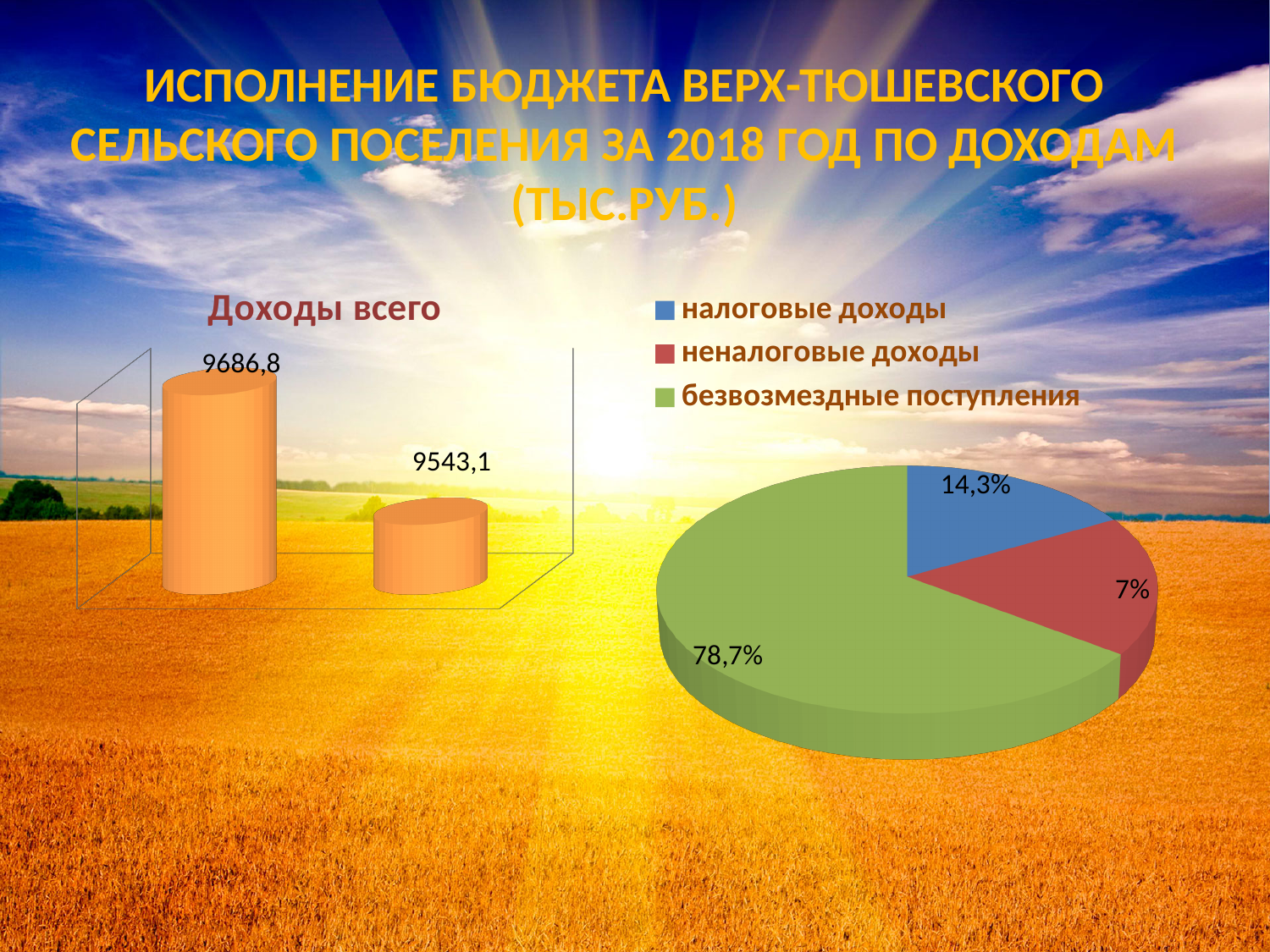
In the bar chart titled "Доходы всего", what value is printed on the left bar? 9686,8 In the pie chart on the right, which category has the largest share? безвозмездные поступления In the bar chart titled "Доходы всего", what is the difference between the left bar value and the right bar value? 143,7 In the pie chart on the right, what share is shown for "неналоговые доходы"? 7% In the bar chart titled "Доходы всего", what value is printed on the right bar? 9543,1 In the pie chart on the right, what share is shown for "безвозмездные поступления"? 78,7% In the pie chart on the right, which category has the smallest share? неналоговые доходы In the pie chart on the right, what share is shown for "налоговые доходы"? 14,3% How many entries does the legend of the pie chart on the right list? 3 In the bar chart titled "Доходы всего", which bar is taller, the left one or the right one? the left one What kind of chart is the chart titled "Доходы всего" on the left of the slide? bar chart How many bars are shown in the bar chart titled "Доходы всего"? 2